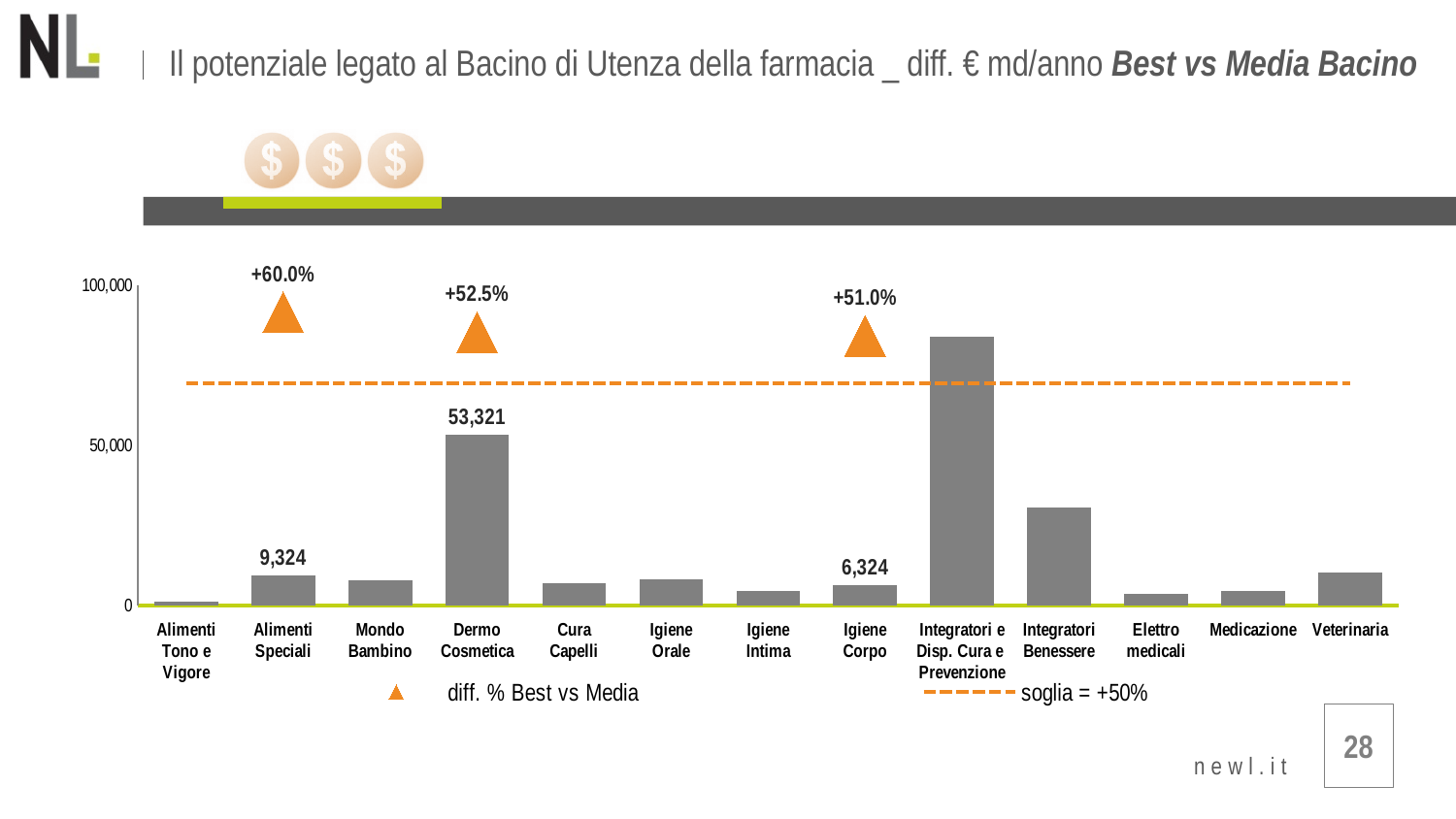
What is the difference between the values for Dermo Cosmetica and Alimenti Speciali? 43,997 Which category has the lowest bar? Alimenti Tono e Vigore Is the value for Integratori Benessere greater or less than 50,000? less Which category has the highest bar? Integratori e Disp. Cura e Prevenzione What value does the dashed soglia line represent according to the legend? +50% What is the value shown for Dermo Cosmetica? 53,321 What is the value shown for Alimenti Speciali? 9,324 What diff. % Best vs Media is shown above Alimenti Speciali? +60.0% What is the value shown for Igiene Corpo? 6,324 Which is larger, the value for Alimenti Speciali or the value for Igiene Corpo? Alimenti Speciali How many categories are shown on the x axis? 13 What diff. % Best vs Media is shown above Dermo Cosmetica? +52.5%